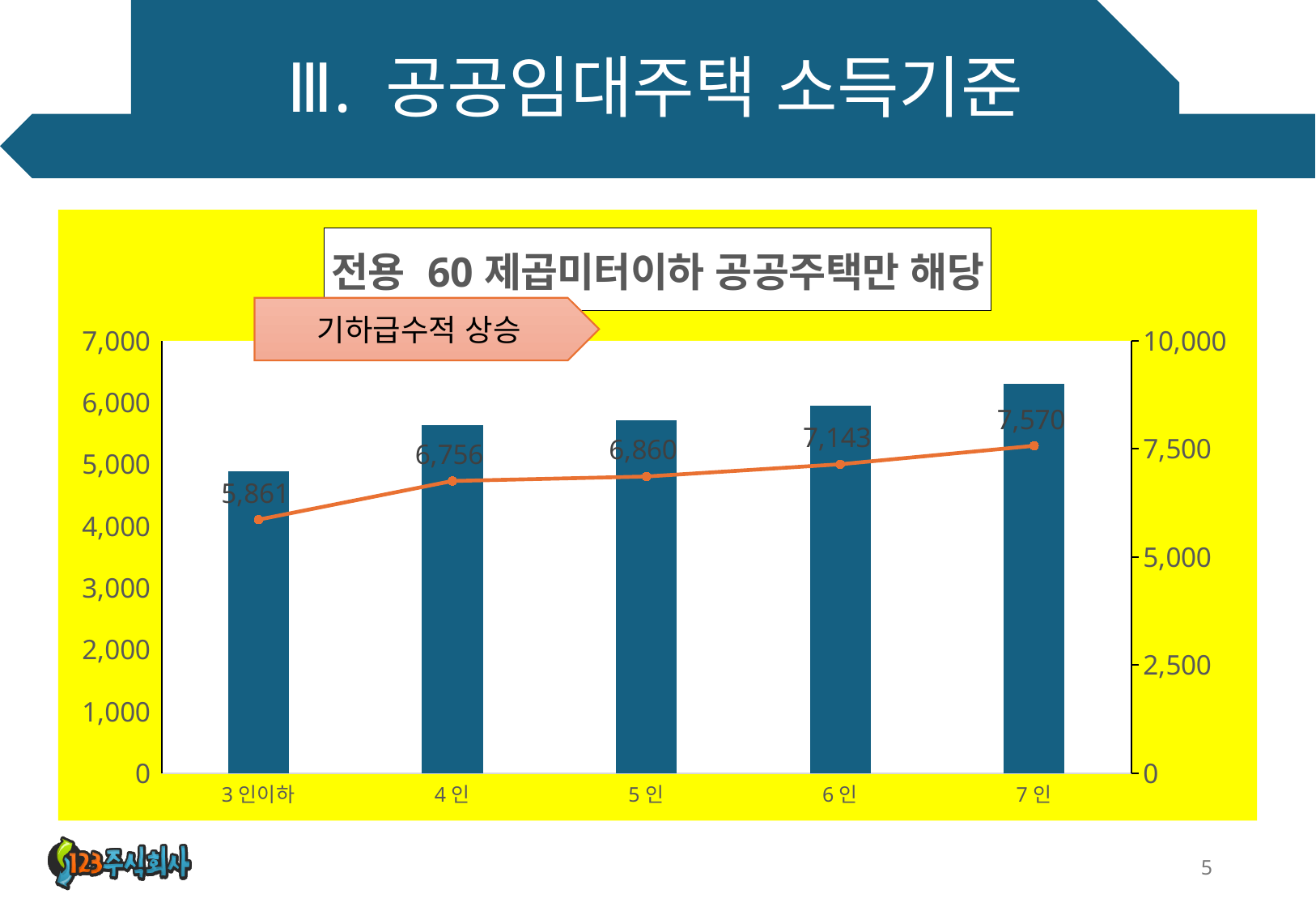
What is the line value for 5 인? 6,860 How many categories are shown on the x axis? 5 Do the line values rise or fall from 3 인이하 to 7 인? rise Is the bar value for 7 인 greater or less than 6,000 on the left axis? greater What is the line value for 3 인이하? 5,861 What is the line value for 7 인? 7,570 What is the title shown above the chart? 전용 60 제곱미터이하 공공주택만 해당 Which category has the highest line value? 7 인 Which has the larger line value, 4 인 or 6 인? 6 인 Which category has the lowest line value? 3 인이하 What is the difference between the line values for 7 인 and 6 인? 427